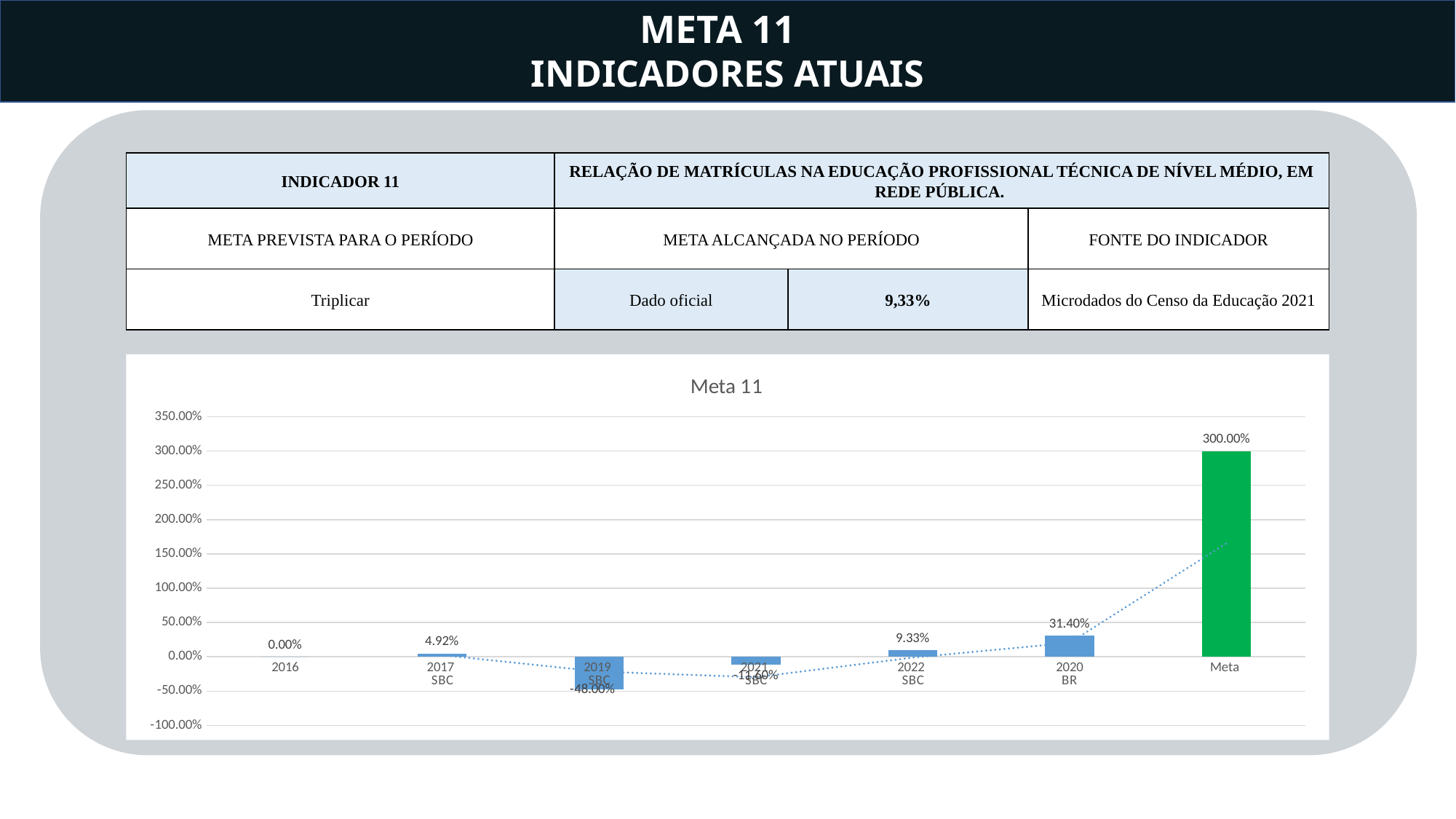
Which category has the highest value in the chart? Meta Is the value for 2021 SBC greater or less than 0.00%? less Which is larger, the value for 2022 SBC or the value for 2017 SBC? 2022 SBC What is the value for 2020 BR in the chart? 31.40% How many categories are shown on the x axis of the chart? 7 What is the difference between the value for Meta and the value for 2020 BR? 268.60% What is the value for Meta in the chart? 300.00% What is the value for 2019 SBC in the chart? -48.00% What kind of chart is shown on the slide? bar chart What is the value for 2017 SBC in the chart? 4.92% Which category has the lowest value in the chart? 2019 SBC What is the value for 2022 SBC in the chart? 9.33%